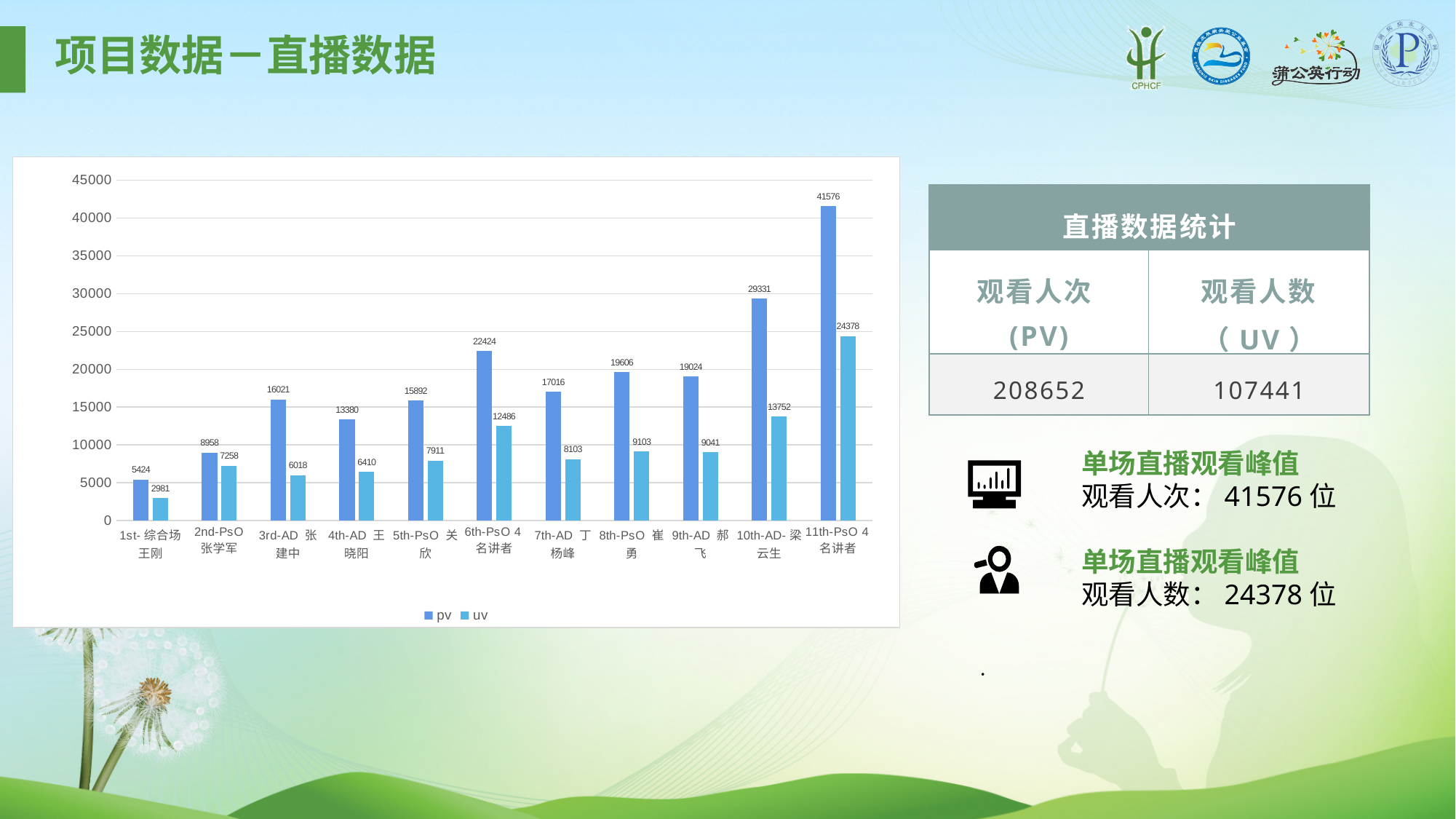
How many categories are shown on the x axis of the chart? 11 What is the uv value for 6th-PsO 4名讲者? 12486 Which category has the highest pv value? 11th-PsO 4名讲者 What kind of chart is shown on the slide? bar chart What are the two series names listed in the chart legend? pv and uv Which category has the lowest uv value? 1st-综合场 王刚 Is the pv value for 3rd-AD 张建中 greater or less than 15000? greater What is the pv value for 1st-综合场 王刚? 5424 Which is larger, the pv value for 8th-PsO 崔勇 or the pv value for 9th-AD 郝飞? 8th-PsO 崔勇 What is the pv value for 10th-AD-梁云生? 29331 What is the difference between the pv and uv values for 11th-PsO 4名讲者? 17198 How many series does the chart legend list? 2